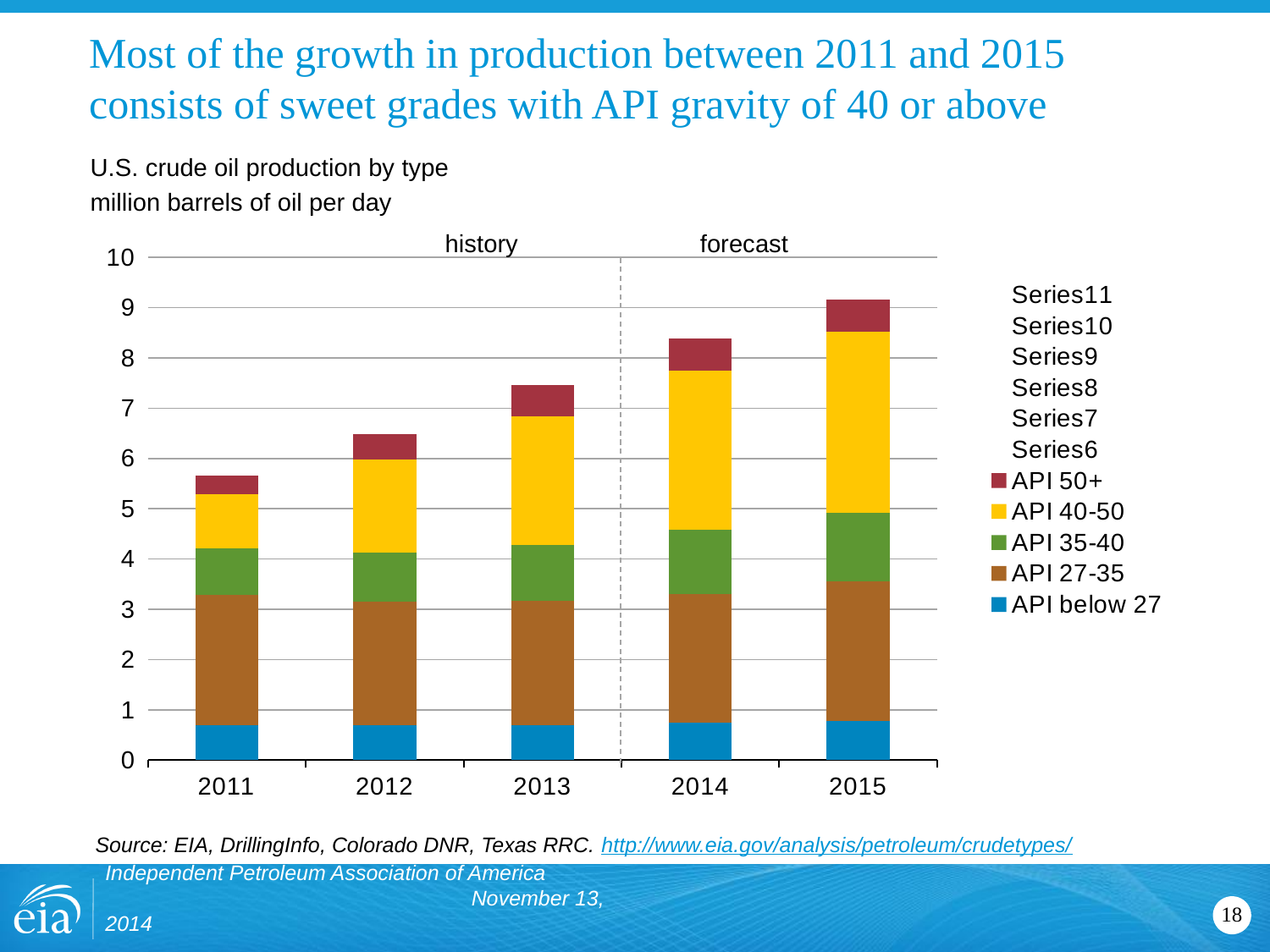
Which year has the larger total production, 2013 or 2014? 2014 How many years are shown on the x axis of the chart? 5 Which year has the lowest total crude oil production? 2011 Does total crude oil production rise or fall from 2011 to 2015? rise Is the total production for 2013 greater or less than 8 million barrels per day? less Is the total production for 2015 greater or less than 8 million barrels per day? greater What unit is the chart's y axis measured in? million barrels of oil per day Which year has the highest total crude oil production? 2015 How many API gravity categories does the legend list with colour swatches? 5 Is the total production for 2011 greater or less than 6 million barrels per day? less What kind of chart is shown on the slide? stacked bar chart Which years on the chart fall in the forecast period? 2014 and 2015